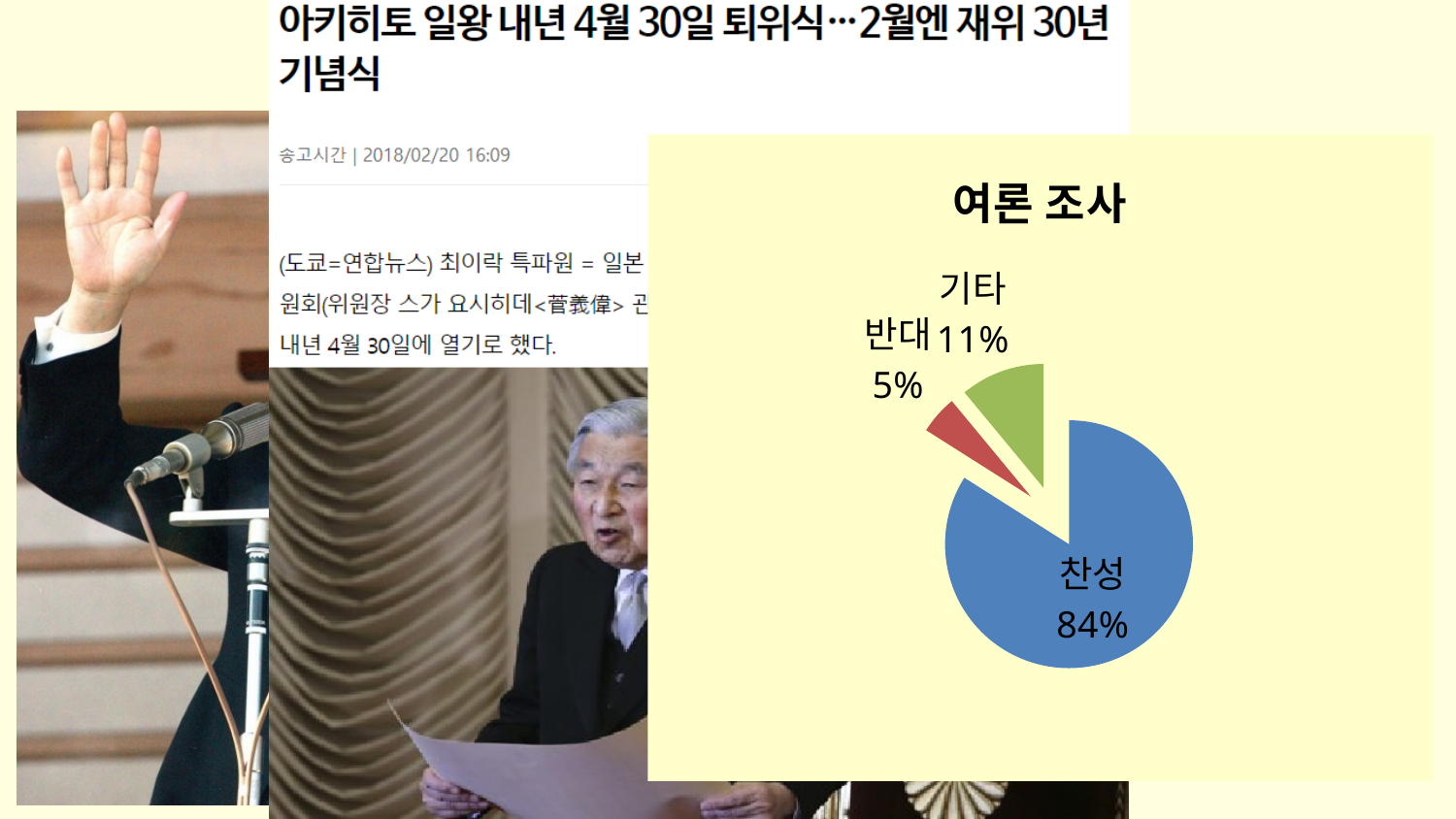
What colour is the 찬성 slice? blue What is the title of the chart? 여론 조사 What kind of chart is shown on the slide? pie chart What is the difference in percentage points between 찬성 and 기타? 73 Which category has the largest share of the pie? 찬성 What percentage is shown for 찬성? 84% What is the difference in percentage points between 기타 and 반대? 6 What percentage is shown for 반대? 5% Which is larger, the share for 기타 or the share for 반대? 기타 What percentage is shown for 기타? 11% Which category has the smallest share of the pie? 반대 How many slices does the pie chart have? 3